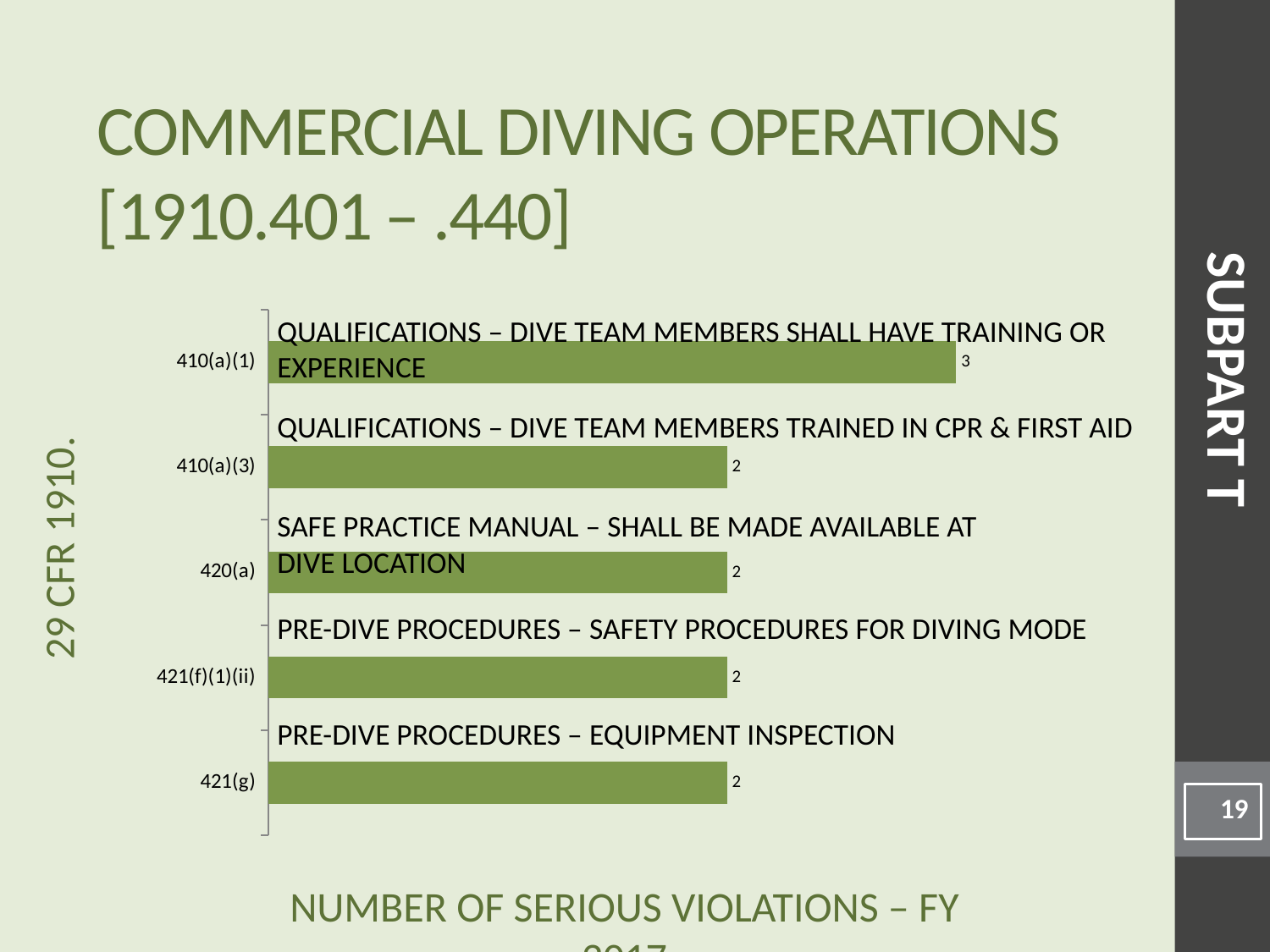
What is the number of serious violations for 410(a)(3)? 2 How many standards (categories) are shown in the chart? 5 What kind of chart is shown on the slide? Bar chart What description is given for the bar labelled 421(g)? PRE-DIVE PROCEDURES – EQUIPMENT INSPECTION What is the total number of serious violations across all five standards shown? 11 What is the number of serious violations for 421(g)? 2 What is the number of serious violations for 420(a)? 2 What is the number of serious violations for 410(a)(1)? 3 Which standard has the highest number of serious violations? 410(a)(1) What is the label on the vertical axis of the chart? 29 CFR 1910. Which has more serious violations, 410(a)(1) or 410(a)(3)? 410(a)(1) What is the difference between the number of serious violations for 410(a)(1) and 421(f)(1)(ii)? 1